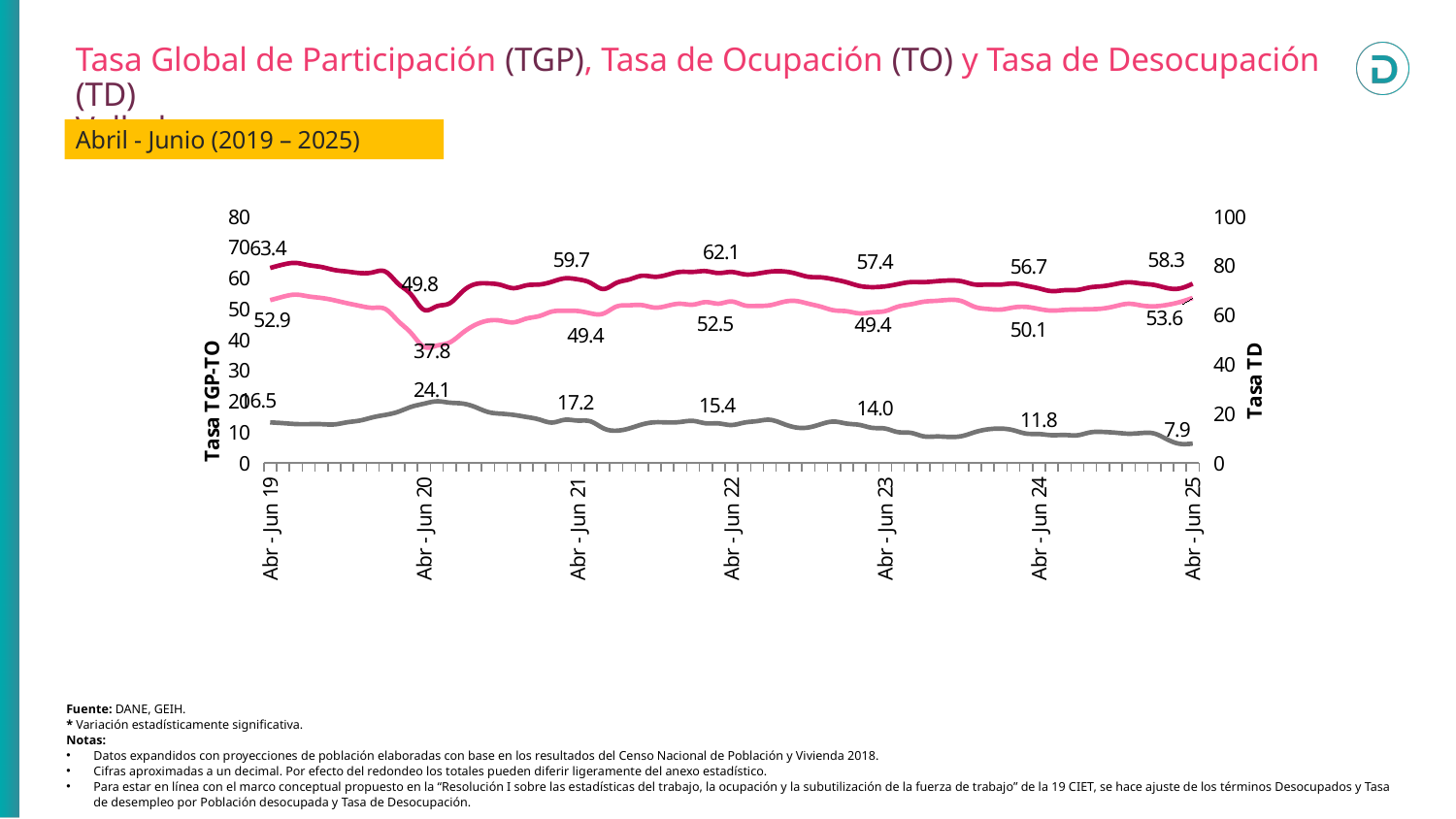
Does the TD (gray line) rise or fall from Abr - Jun 20 to Abr - Jun 25? Fall What is the title of the right-hand vertical axis? Tasa TD What kind of chart is shown on the slide? Line chart In which labeled period is the TGP (dark red line) lowest? Abr - Jun 20 How many labeled periods (Abr - Jun) are shown on the x axis? 7 In which labeled period is the TD (gray line) highest? Abr - Jun 20 What is the difference between the TGP values for Abr - Jun 22 and Abr - Jun 23? 4.7 What is the TD value (gray line) for Abr - Jun 25? 7.9 What is the TO value (pink line) for Abr - Jun 20? 37.8 What is the difference between the TD values for Abr - Jun 20 and Abr - Jun 25? 16.2 What is the TGP value (top, dark red line) for Abr - Jun 22? 62.1 Which period has the larger TO value, Abr - Jun 19 or Abr - Jun 25? Abr - Jun 25